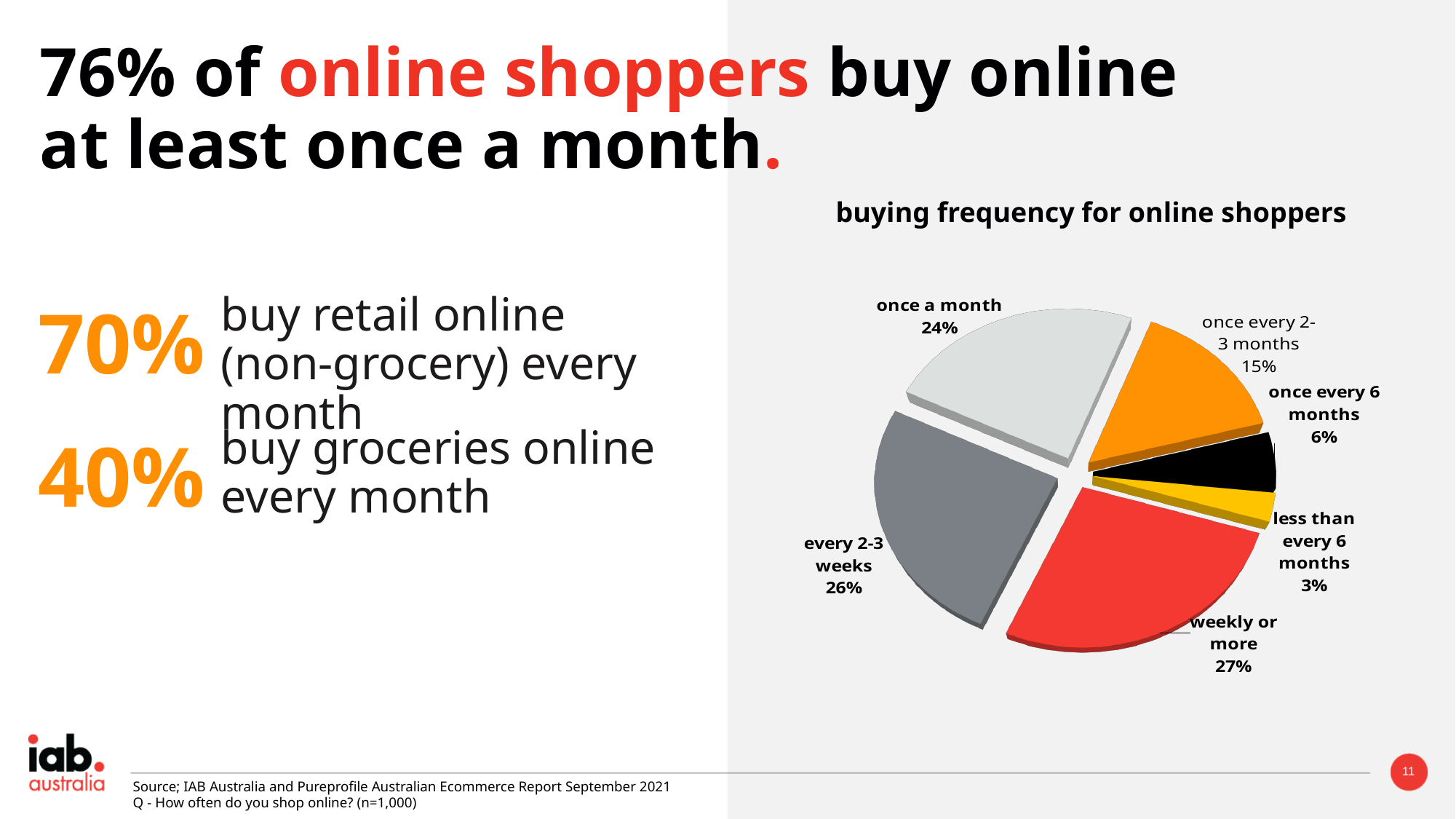
What is the difference between the share for once a month and the share for once every 6 months? 18% What is the title of the chart? buying frequency for online shoppers What share of online shoppers buy once every 2-3 months? 15% How many slices does the pie chart have? 6 What share of online shoppers buy every 2-3 weeks? 26% Which is larger: the share for once every 2-3 months or the share for once every 6 months? once every 2-3 months Which buying frequency has the smallest share of the pie? less than every 6 months What share of online shoppers buy weekly or more? 27% Which buying frequency has the largest share of the pie? weekly or more What share of online shoppers buy once a month? 24% What type of chart is shown on the slide? pie chart What share of online shoppers buy less than every 6 months? 3%